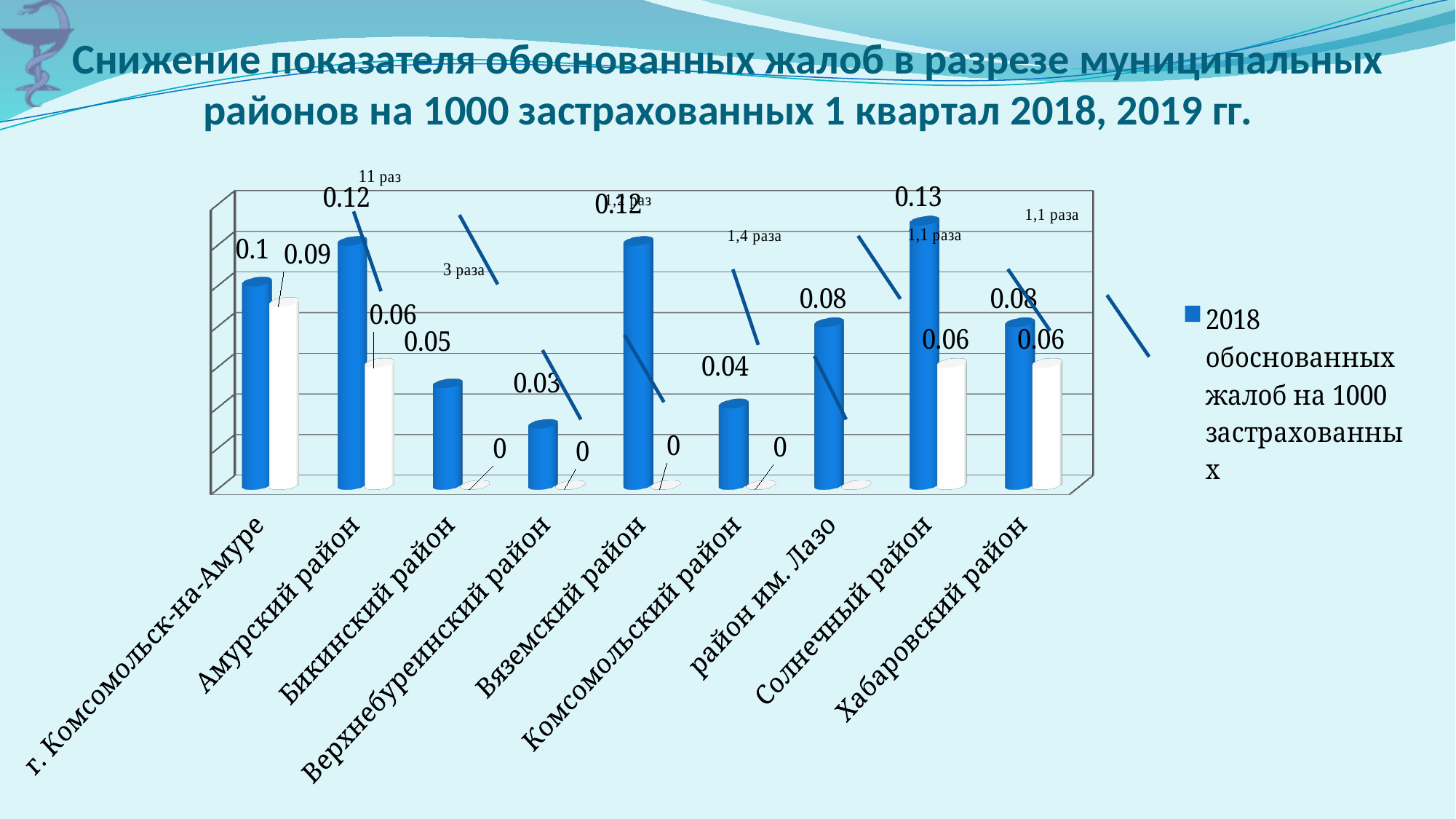
What is the 2018 value (blue bar) for Амурский район? 0.12 What is the text of the legend entry shown to the right of the chart? 2018 обоснованных жалоб на 1000 застрахованных What is the 2018 value (blue bar) for Верхнебуреинский район? 0.03 What is the difference between the blue bar and the white bar for Солнечный район? 0.07 Which district has the highest 2018 value (blue bar)? Солнечный район What kind of chart is shown on the slide? bar chart Which has the larger 2018 value (blue bar): г. Комсомольск-на-Амуре or Бикинский район? г. Комсомольск-на-Амуре What is the 2018 value (blue bar) for Солнечный район? 0.13 Which district has the lowest 2018 value (blue bar)? Верхнебуреинский район What is the difference between the blue bar and the white bar for Амурский район? 0.06 What is the value of the white bar for г. Комсомольск-на-Амуре? 0.09 How many municipal districts (categories) are shown on the x axis of the chart? 9